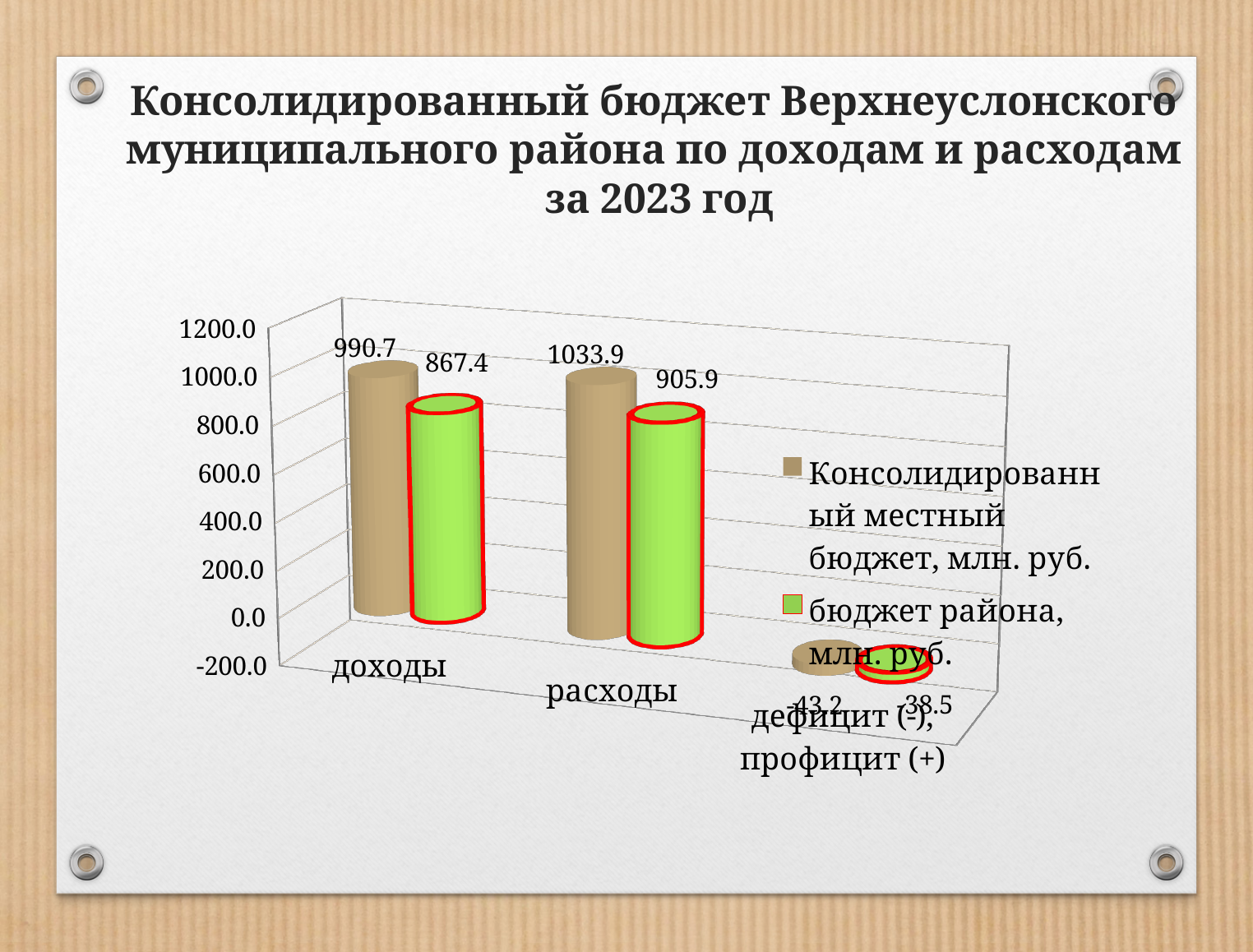
How many categories are shown on the x axis? 3 What is the value of бюджет района for доходы? 867.4 What is the difference between the consolidated local budget and бюджет района for доходы? 123.3 How many series does the legend list? 2 What is the value of the consolidated local budget (Консолидированный местный бюджет) for доходы? 990.7 Which category has the lowest value for the бюджет района series? дефицит (-), профицит (+) For расходы, which series has the larger value: the consolidated local budget or бюджет района? Консолидированный местный бюджет, млн. руб. Which category has the highest value for the consolidated local budget series? расходы What is the value of бюджет района for дефицит (-), профицит (+)? -38.5 What is the value of the consolidated local budget for расходы? 1033.9 What kind of chart is shown on the slide? bar chart What is the value of бюджет района for расходы? 905.9